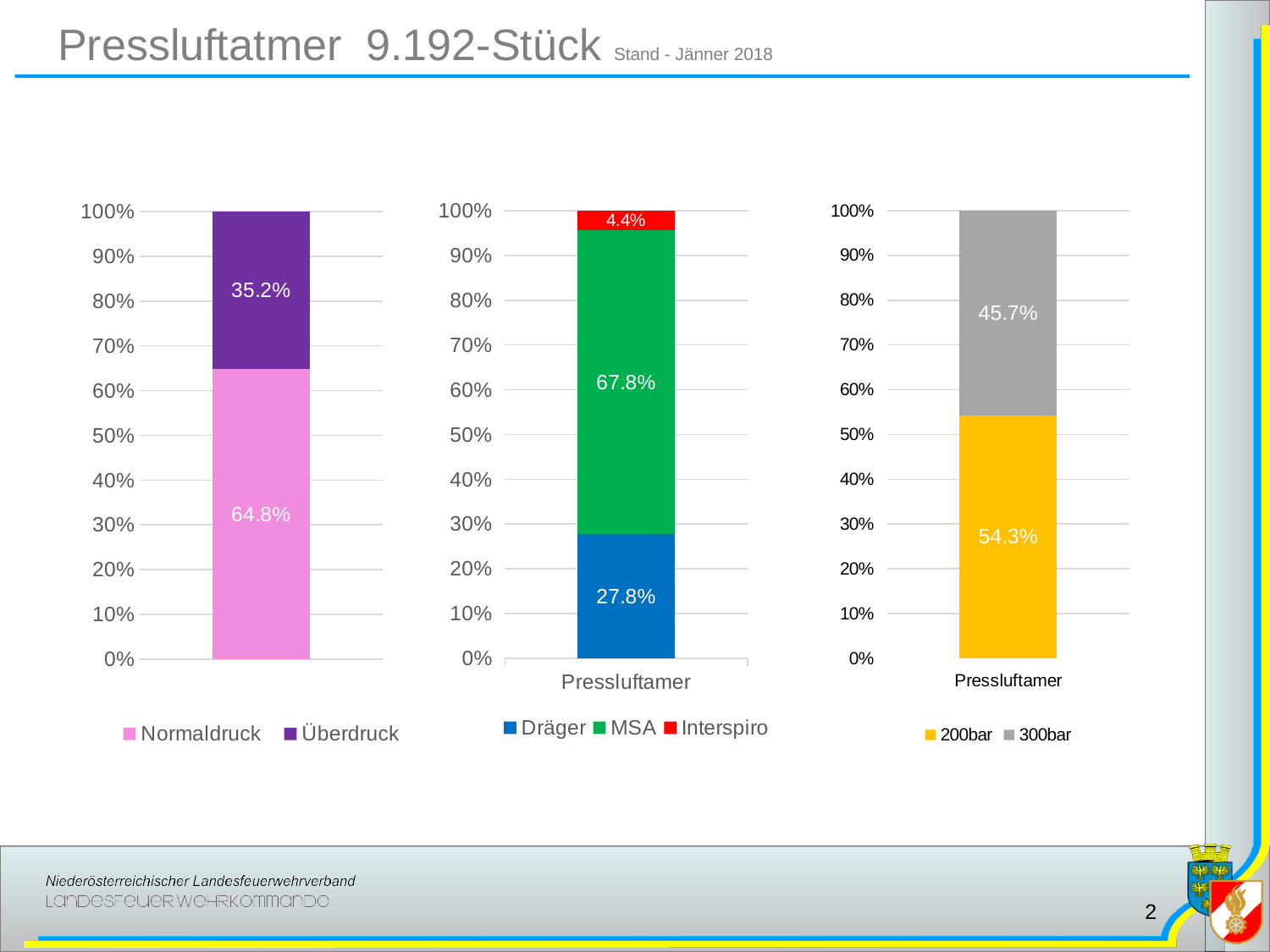
How many series does the legend of the middle chart list? 3 In the right chart, what is the value for 200bar? 54.3% In the middle chart, what is the value for Interspiro? 4.4% In the left chart, what is the difference between Normaldruck and Überdruck? 29.6% In the middle chart, what is the difference between Dräger and Interspiro? 23.4% In the middle chart, which series has the largest share? MSA In the right chart, which is larger, 200bar or 300bar? 200bar What kind of chart is the right chart? Stacked bar chart In the middle chart, which series has the smallest share? Interspiro In the middle chart, what is the value for MSA? 67.8% In the left chart, what is the value for Überdruck? 35.2% In the left chart, what is the value for Normaldruck? 64.8%